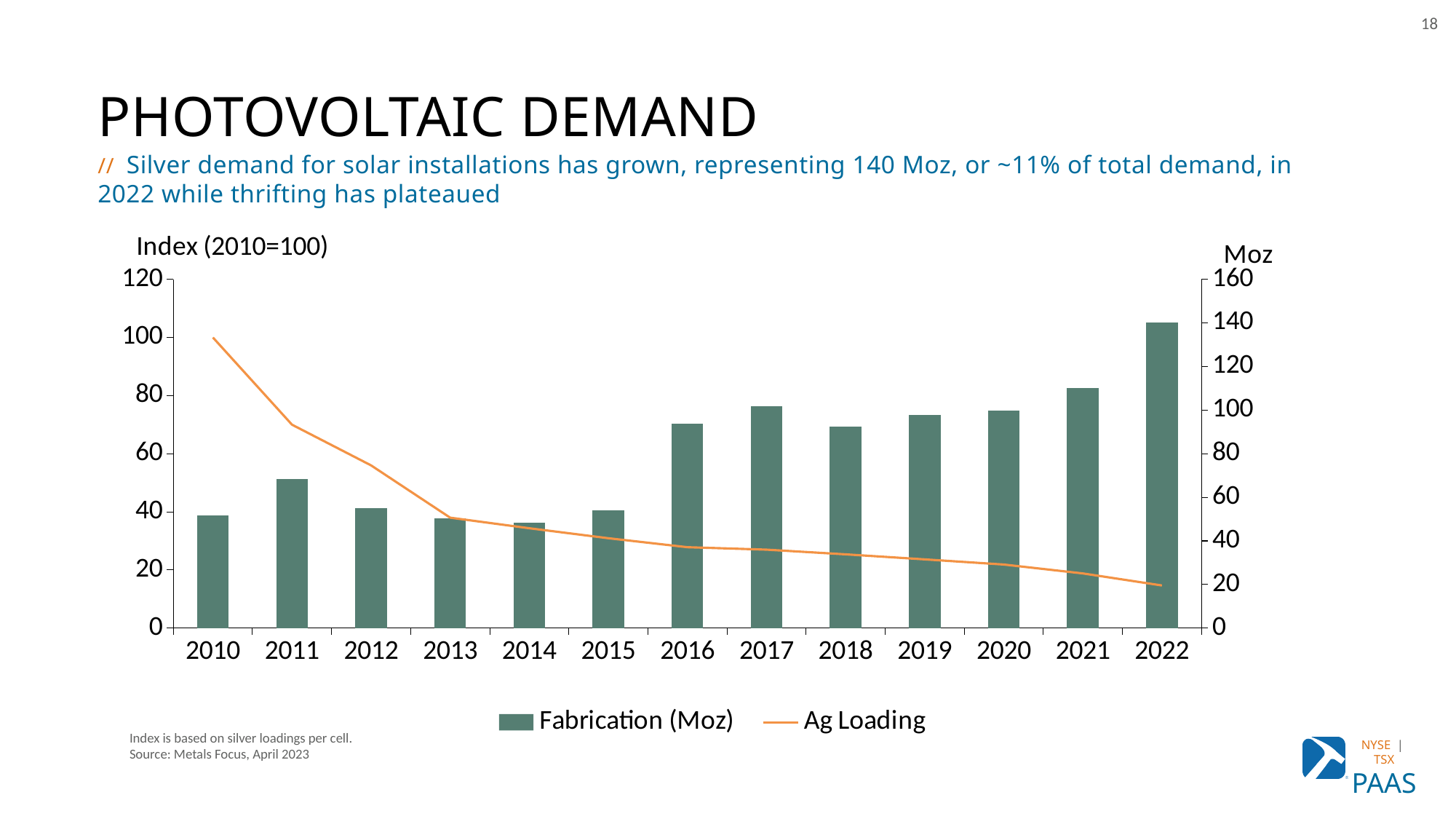
Which year has the highest Fabrication (Moz) bar? 2022 Does the Ag Loading line rise or fall from 2010 to 2022? It falls Is the Ag Loading index value for 2022 greater or less than 20? less How many years are shown on the x axis of the chart? 13 Is the Fabrication (Moz) value for 2010 greater or less than 60? less Is the Fabrication (Moz) value for 2021 greater or less than 100? greater What is the label of the right-hand vertical axis? Moz How many series does the legend list? 2 Which is larger, the Fabrication (Moz) bar for 2010 or for 2011? 2011 What kind of chart is shown on the slide? A combination bar and line chart